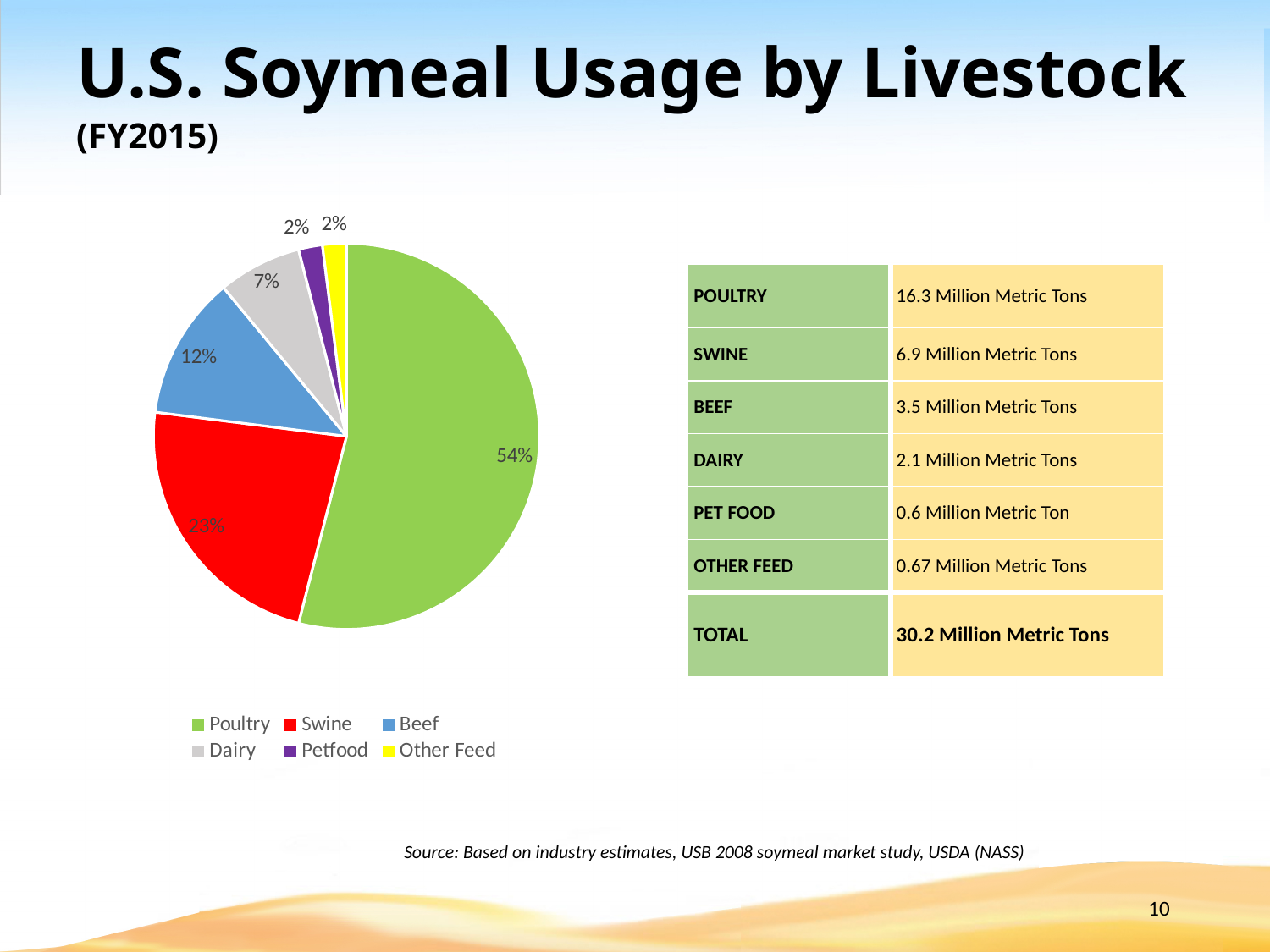
What share of the pie does Poultry account for? 54% What is the difference in percentage points between the Poultry and Swine slices? 31% What share of the pie does Dairy account for? 7% Which slice is larger, Swine or Beef? Swine What type of chart is shown on the slide? pie chart What share of the pie does Petfood account for? 2% What colour is the Swine slice in the pie chart? red Which category has the largest slice of the pie? Poultry What is the title of the slide containing the pie chart? U.S. Soymeal Usage by Livestock (FY2015) How many categories does the pie chart show? 6